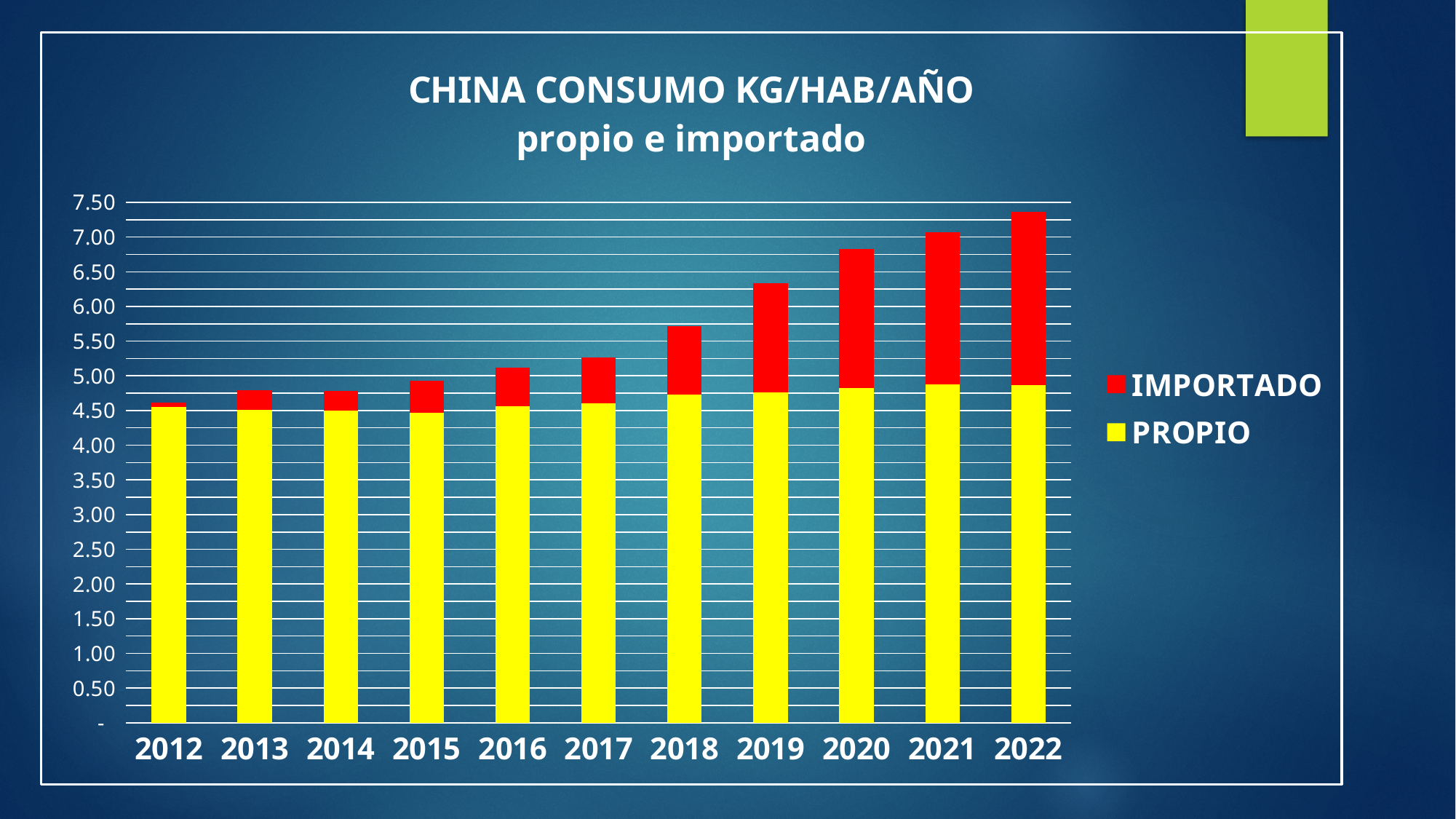
Is the total value for 2022 greater or less than 7.00? greater Which year has the larger IMPORTADO segment, 2012 or 2022? 2022 How many series does the legend list? 2 Which colour represents the PROPIO series in the chart? Yellow Is the total value for 2019 greater or less than 6.00? greater Do the total bar heights rise or fall from 2012 to 2022? Rise Which year has the highest total bar? 2022 How many years are shown on the x axis of the chart? 11 Which year has the lowest total bar? 2012 Is the total value for 2020 greater or less than 7.00? less What kind of chart is shown on the slide? Stacked bar chart